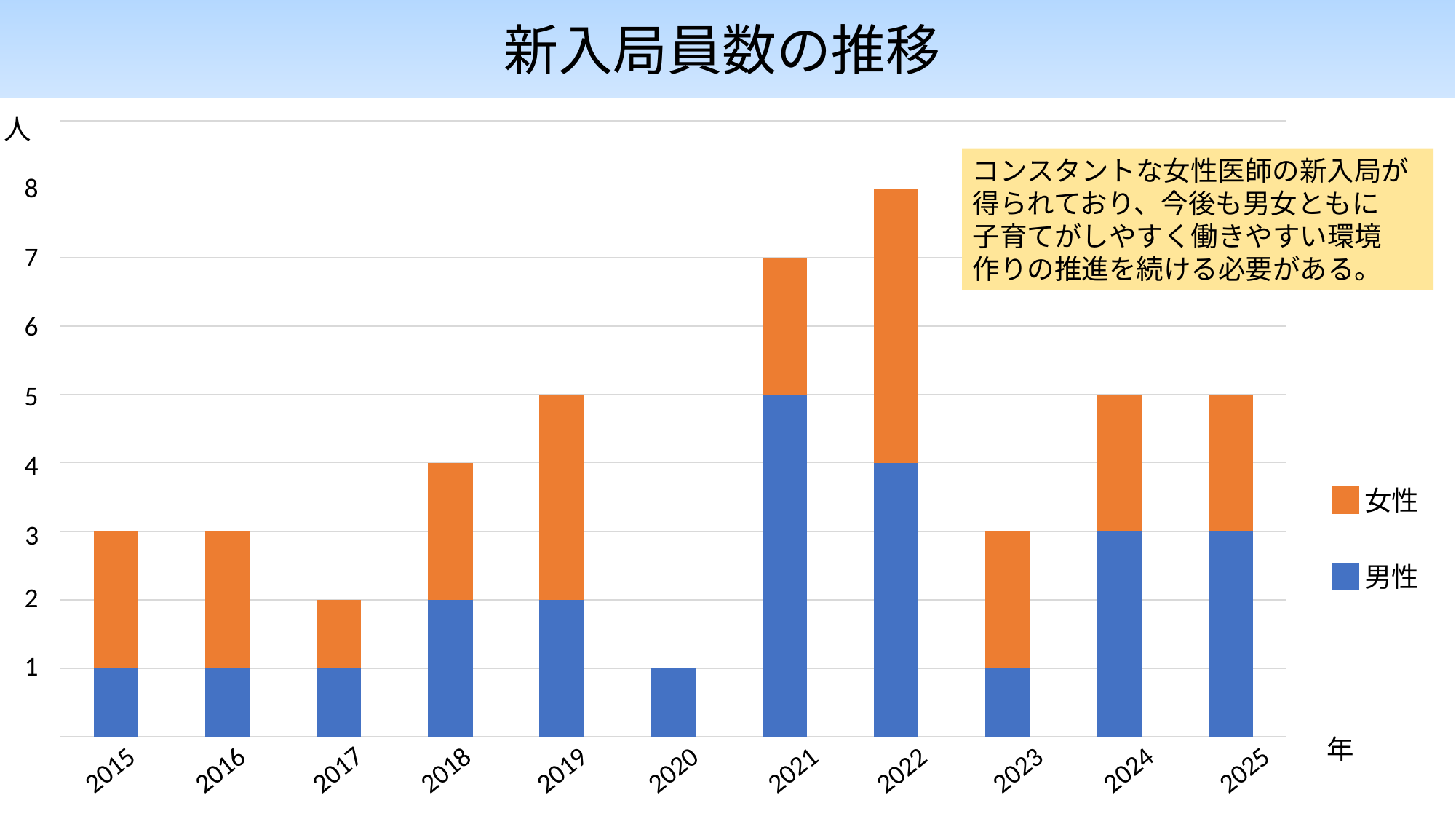
How many series does the legend list? 2 How many years are shown on the x axis? 11 What kind of chart is shown on the slide? stacked bar chart Which year has the lowest total number of new members? 2020 What is the total height of the stacked bar for 2022? 8 Which series is shown in orange in the legend? 女性 What is the difference between the total for 2021 and the total for 2019? 2 What is the value for 男性 in 2021? 5 What is the value for 男性 in 2024? 3 Which is larger, the total for 2018 or the total for 2023? 2018 Which year has the highest total number of new members? 2022 Is the total for 2021 greater or less than 6? greater